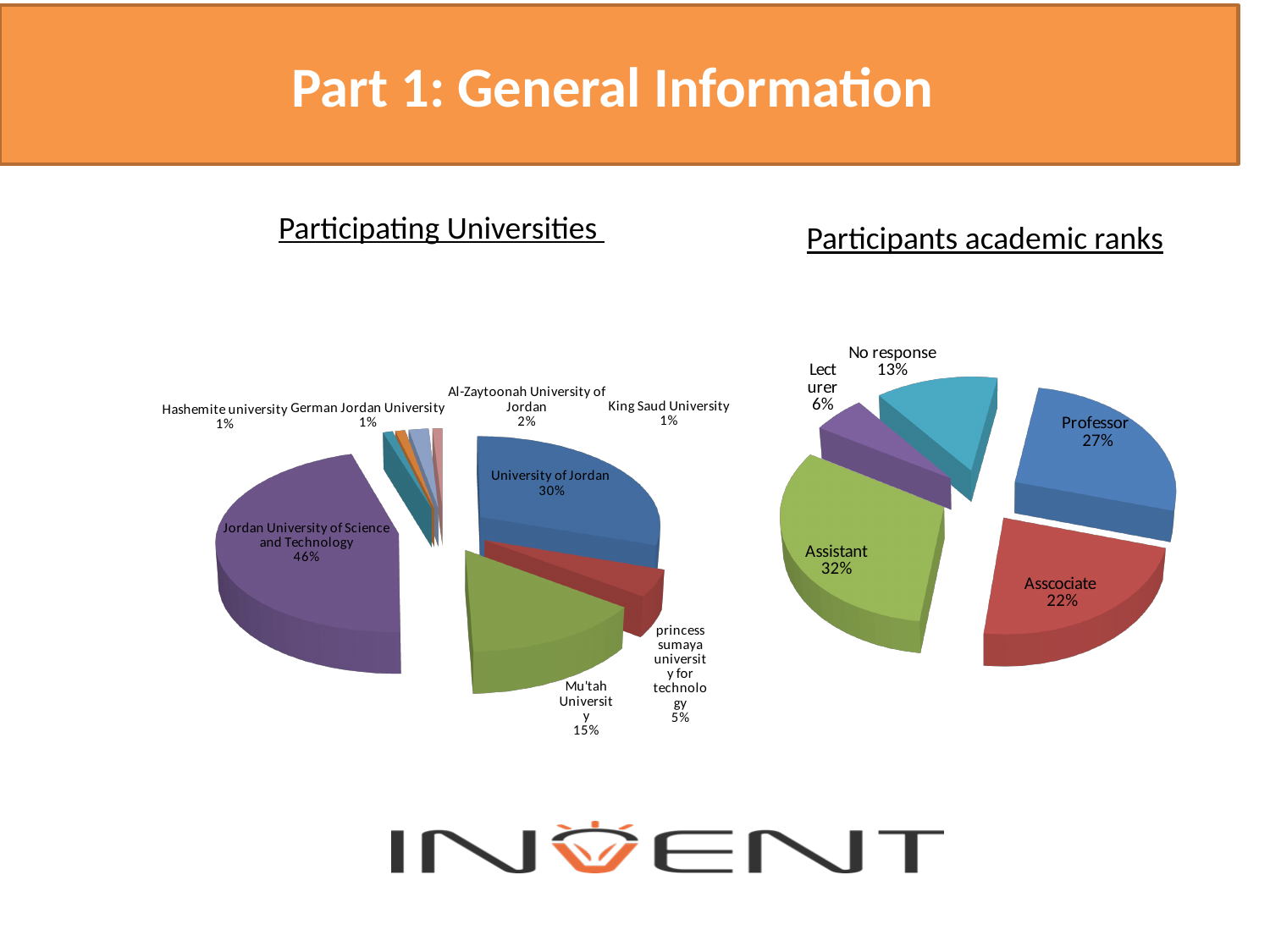
In the Participants academic ranks chart, which category has the smallest share? Lecturer In the Participating Universities chart, what is the difference between the shares of University of Jordan and Mu'tah University? 15% In the Participants academic ranks chart, which is larger: the share for Associate or the share for No response? Associate In the Participating Universities chart, what percentage is shown for University of Jordan? 30% In the Participating Universities chart, what share does Jordan University of Science and Technology have? 46% In the Participating Universities chart, which university has the largest share? Jordan University of Science and Technology In the Participants academic ranks chart, how many categories are shown? 5 In the Participating Universities chart, how many universities are shown as slices? 8 In the Participants academic ranks chart, which rank has the largest share? Assistant In the Participating Universities chart, what is the share for Mu'tah University? 15% What type of chart is used for Participants academic ranks? Pie chart In the Participants academic ranks chart, what percentage of participants are Professors? 27%